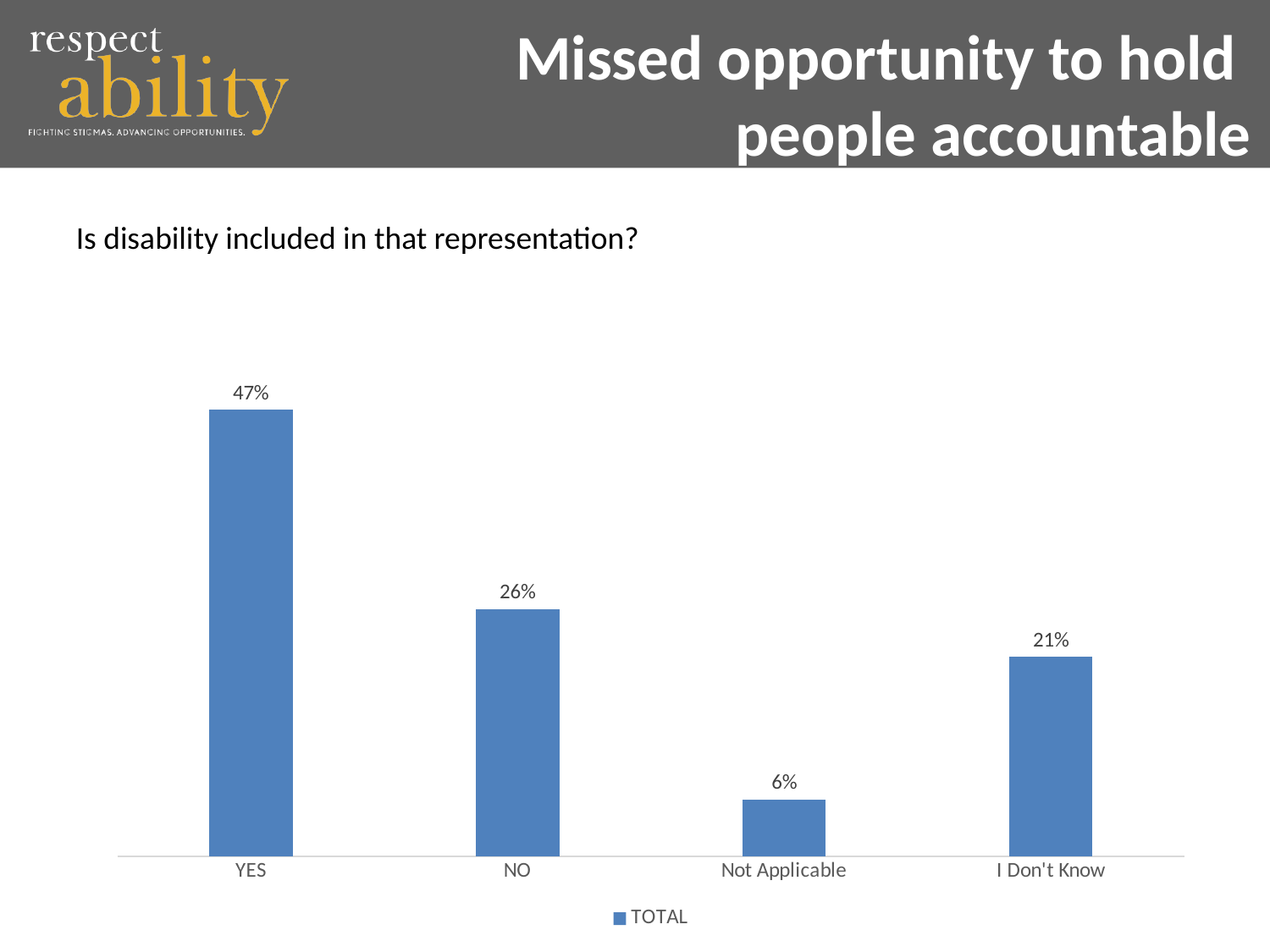
What is the difference between the YES and NO values? 21% What series name does the legend show? TOTAL What is the difference between the NO and I Don't Know values? 5% Which is larger, the value for NO or the value for I Don't Know? NO What percentage of respondents answered YES to whether disability is included in that representation? 47% What type of chart is shown on the slide? Bar chart How many categories are shown on the x axis of the chart? 4 Which category has the highest value? YES What is the value shown for the NO category? 26% What is the value shown for Not Applicable? 6% Which category has the lowest value? Not Applicable What is the value shown for I Don't Know? 21%